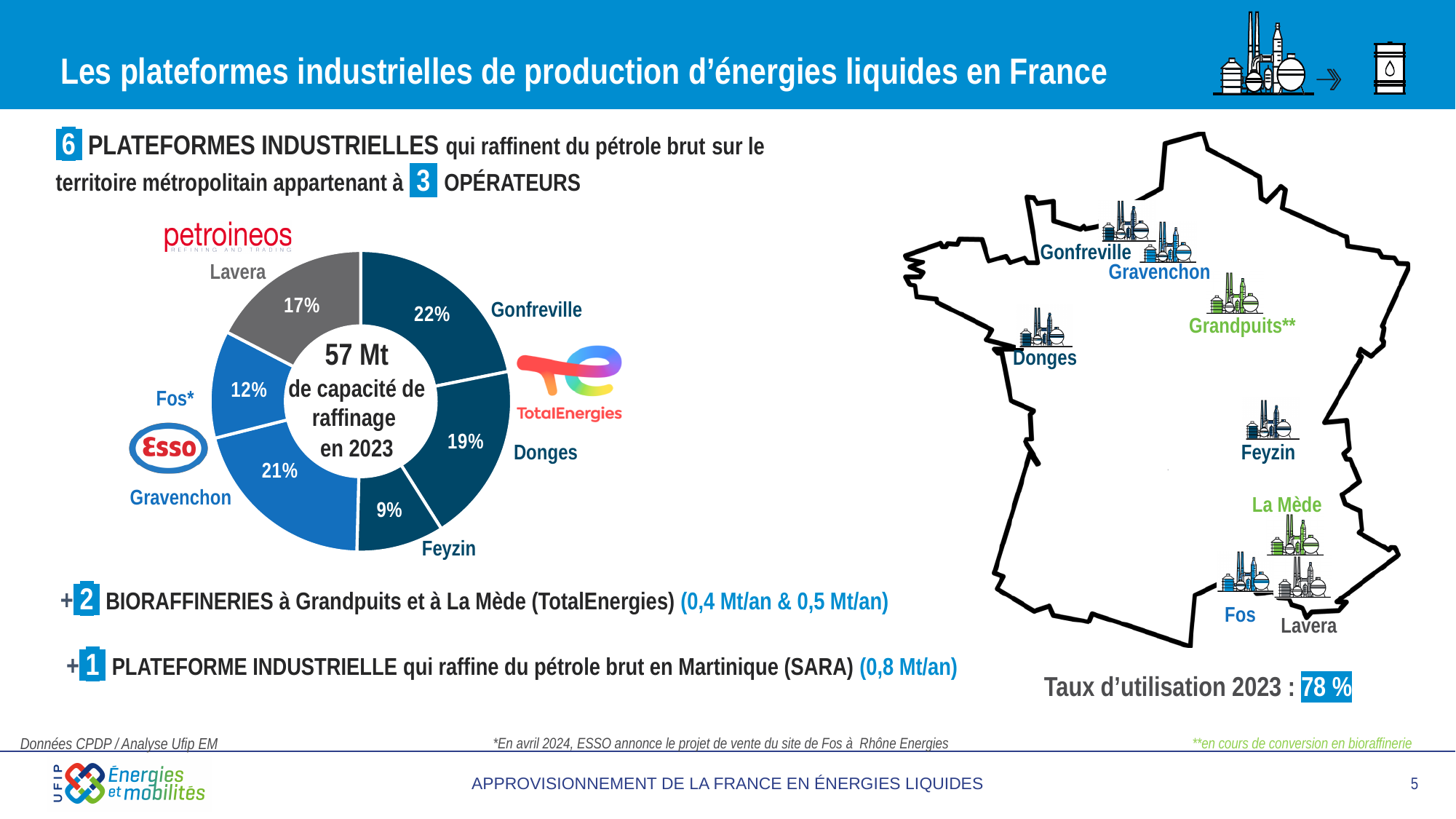
What total refining capacity is written in the centre of the donut chart? 57 Mt What type of chart is used to show the refining capacity shares? Donut (pie) chart What is the combined share of Gonfreville and Donges in the donut chart? 41% What percentage is shown for Fos* in the donut chart? 12% What share of the 2023 refining capacity does Gonfreville represent in the donut chart? 22% How many platforms (slices) are shown in the donut chart? 6 Which platform has the smallest share in the donut chart? Feyzin Which has a larger share in the donut chart, Lavera or Fos*? Lavera What is the difference in percentage points between Gravenchon and Donges in the donut chart? 2 What percentage is shown for Feyzin in the donut chart? 9% Which platform has the largest share in the donut chart? Gonfreville What percentage is shown for Lavera in the donut chart? 17%